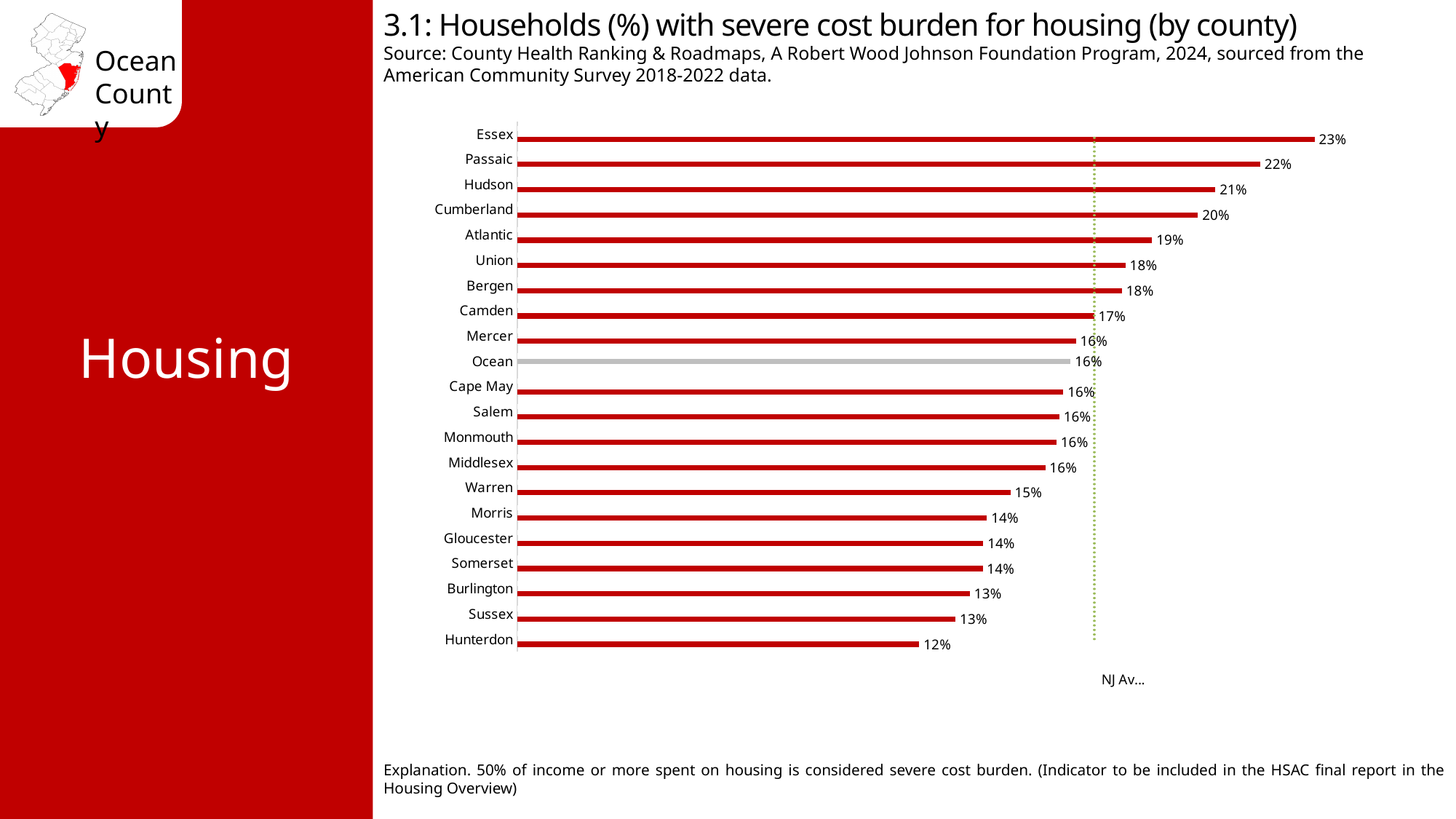
What is the value shown for Essex County? 23% What is the value shown for Cumberland County? 20% What is the value shown for Hunterdon County? 12% Which county has a higher value, Passaic or Hudson? Passaic What type of chart is used on this slide? Bar chart What percentage of households in Ocean County have a severe cost burden for housing? 16% What does the vertical dotted line on the chart represent? NJ Average Which county's bar is coloured grey instead of red? Ocean What is the difference in percentage points between Essex and Hunterdon? 11 percentage points Which county has the highest percentage of households with severe housing cost burden? Essex Which county has the lowest percentage of households with severe housing cost burden? Hunterdon How many counties are shown in the chart? 21